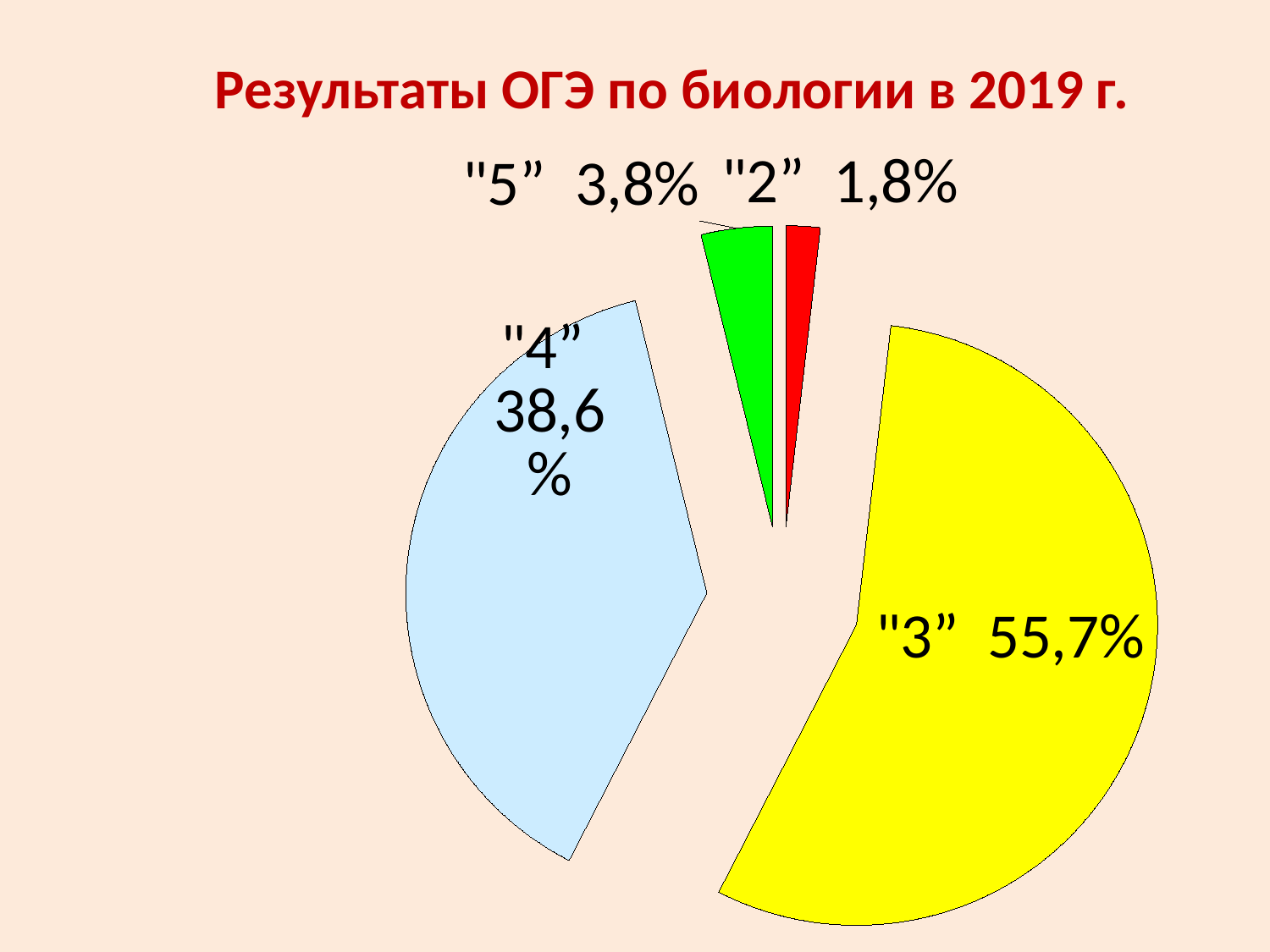
What is the difference between the shares for grade "3" and grade "4"? 17,1% What is the title of the chart? Результаты ОГЭ по биологии в 2019 г. What share of the pie does the grade "4" slice have? 38,6% What share of the pie does the grade "3" slice have? 55,7% Which slice is larger, grade "5" or grade "2"? "5" How many slices does the pie chart have? 4 What share of the pie does the grade "5" slice have? 3,8% What colour is the slice for grade "3"? yellow What kind of chart is shown on the slide? pie chart Which grade has the largest slice of the pie? "3" Which grade has the smallest slice of the pie? "2" What share of the pie does the grade "2" slice have? 1,8%